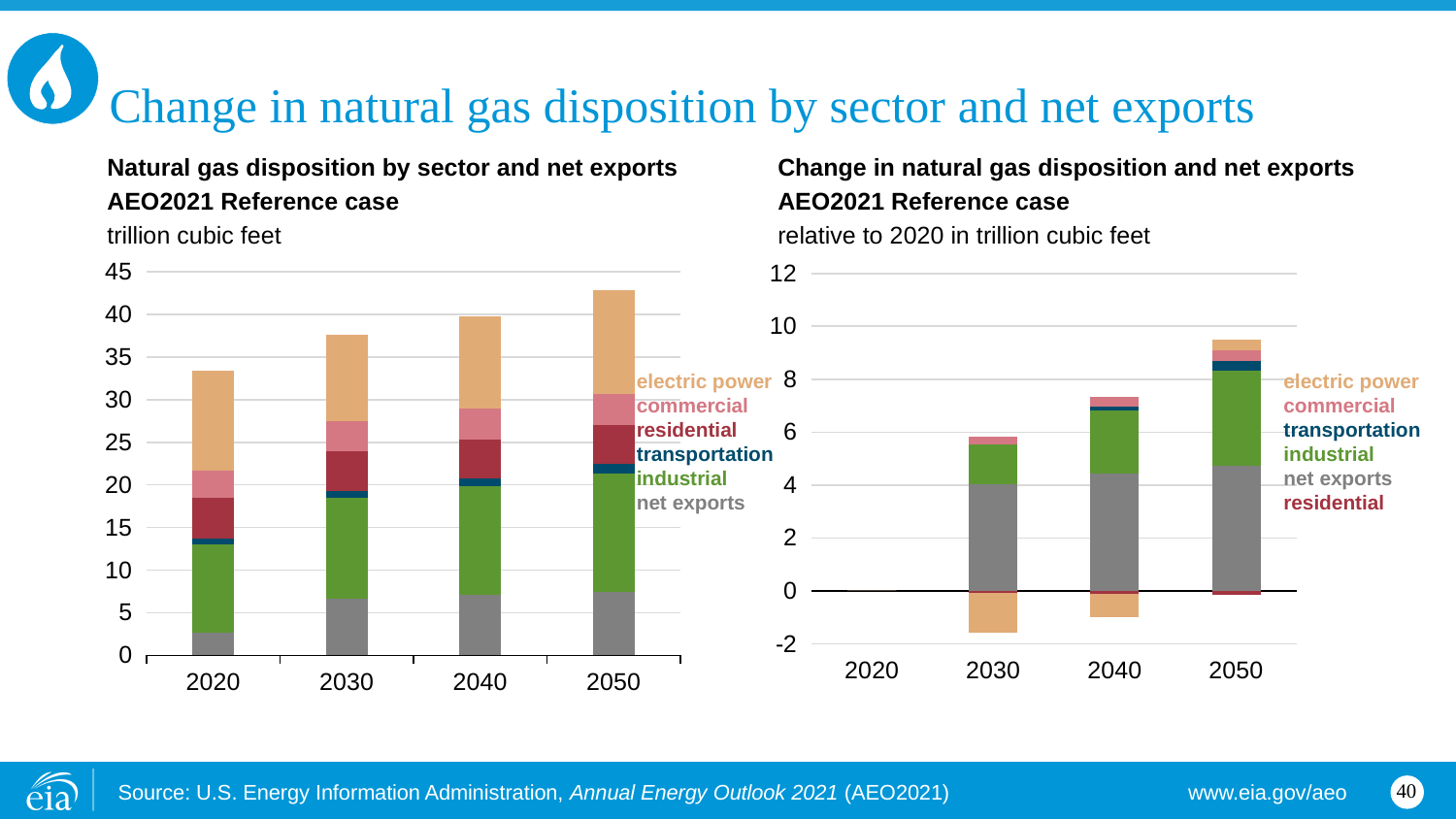
In the left chart, 'Natural gas disposition by sector and net exports', which year has the tallest total bar? 2050 How many series does the legend of the left chart, 'Natural gas disposition by sector and net exports', list? 6 In the left chart, 'Natural gas disposition by sector and net exports', is the total for 2020 greater or less than 30? greater In the left chart, 'Natural gas disposition by sector and net exports', is the total for 2050 greater or less than 40? greater In the right chart, 'Change in natural gas disposition and net exports', which series has the largest segment in 2050? net exports In the right chart, 'Change in natural gas disposition and net exports', which series has a negative value in 2030? electric power In the left chart, 'Natural gas disposition by sector and net exports', which year has the shortest total bar? 2020 In the left chart, 'Natural gas disposition by sector and net exports', do the total bars rise or fall from 2020 to 2050? rise How many years are shown on the x axis of the left chart, 'Natural gas disposition by sector and net exports'? 4 In the left chart, 'Natural gas disposition by sector and net exports', which series is shown in gray at the bottom of each bar? net exports In the right chart, 'Change in natural gas disposition and net exports', is the positive stacked total for 2050 greater or less than 8? greater What kind of chart is the left chart, 'Natural gas disposition by sector and net exports'? stacked bar chart